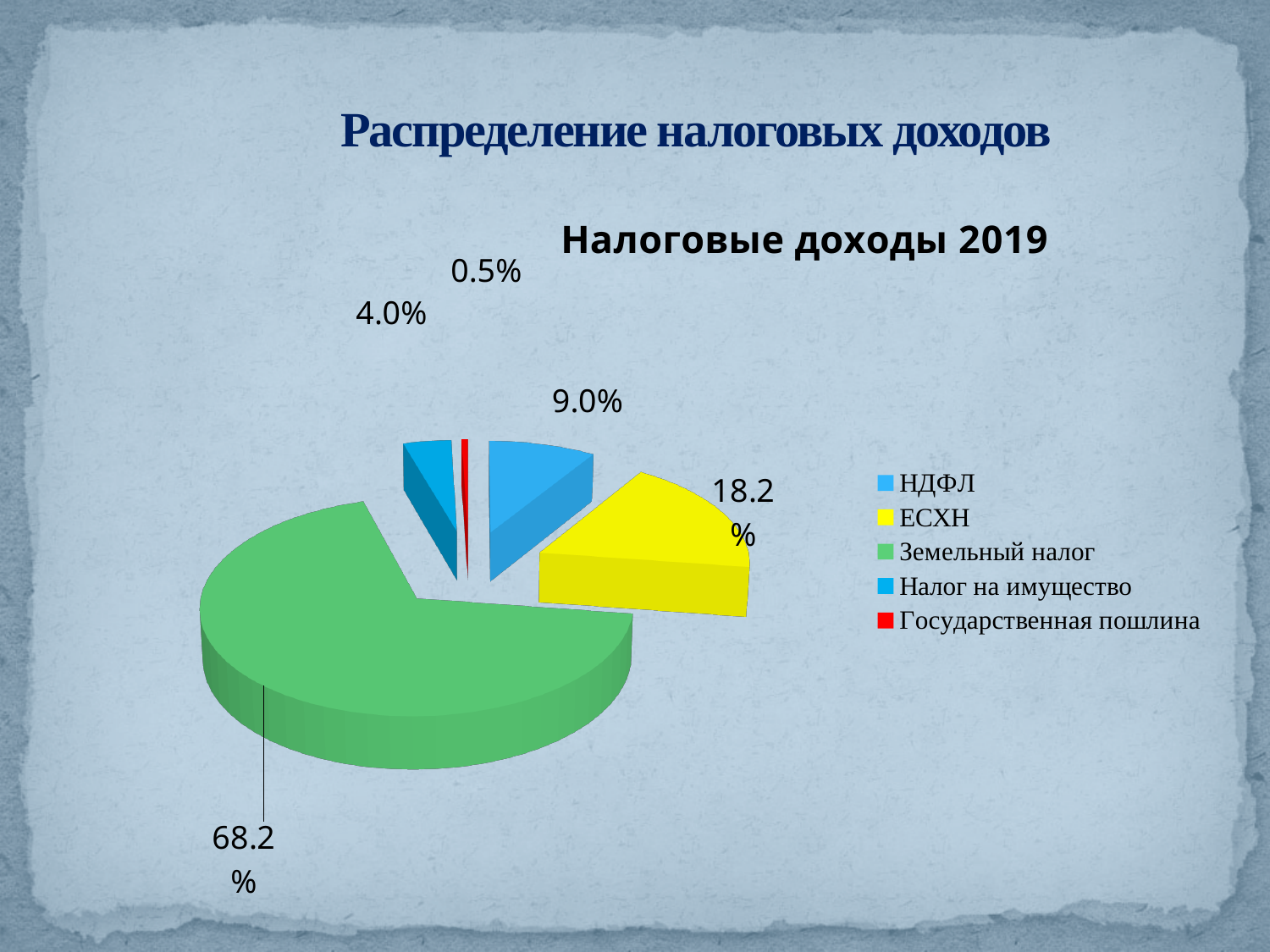
What share of tax revenue does Земельный налог account for? 68.2% Which has a larger share, ЕСХН or Государственная пошлина? ЕСХН What is the title of the chart? Налоговые доходы 2019 What kind of chart is shown on the slide? Pie chart What share of tax revenue does Государственная пошлина account for? 0.5% What colour is the slice for Земельный налог? Green How many categories does the chart's legend list? 5 Which category has the largest share of the pie? Земельный налог By how many percentage points does the share of Земельный налог exceed the share of ЕСХН? 50.0 percentage points Is the share of Земельный налог greater or less than 50%? greater Which category has the smallest share of the pie? Государственная пошлина What share of tax revenue does ЕСХН account for? 18.2%